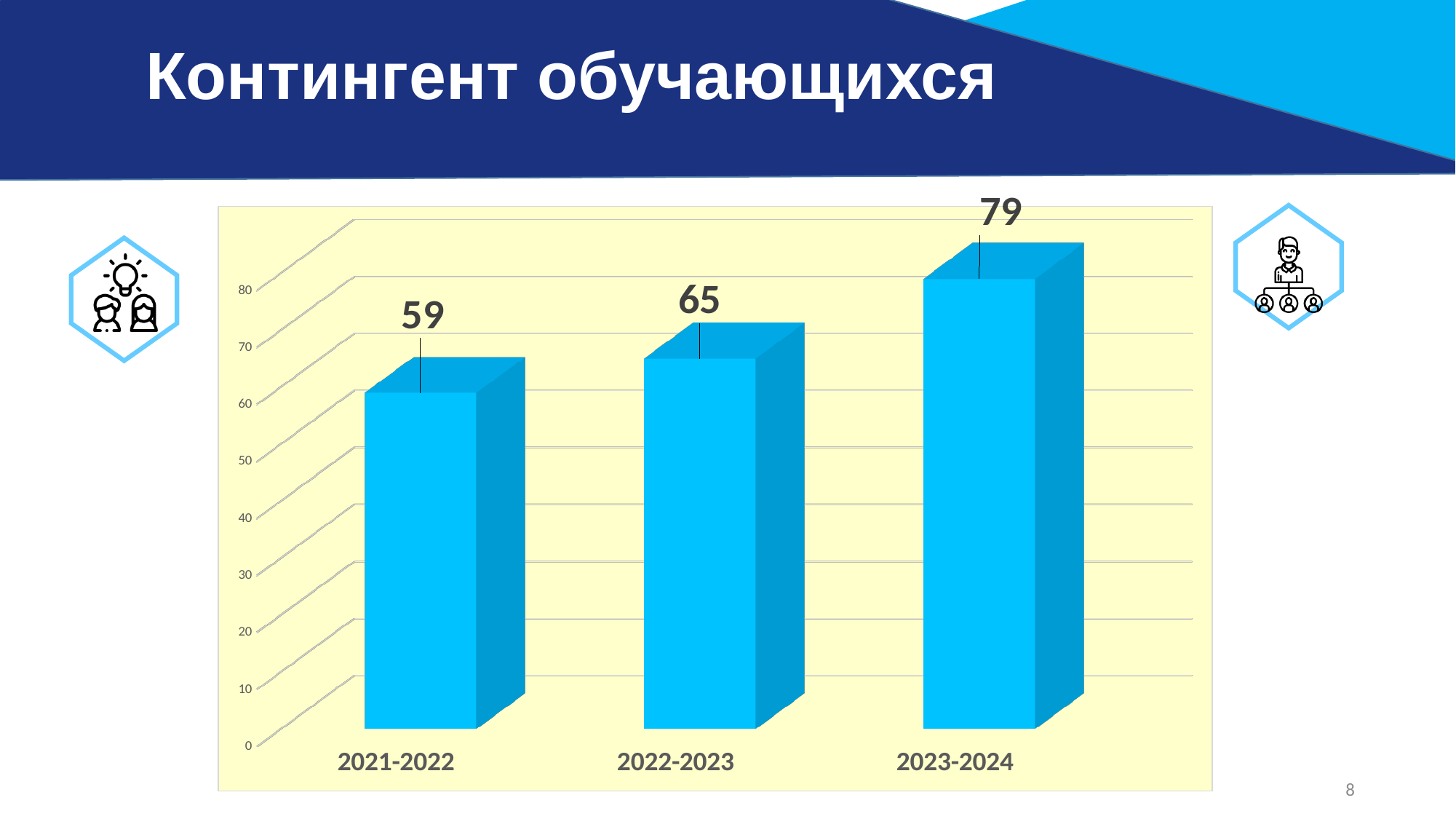
What is the difference between the values for 2023-2024 and 2021-2022? 20 Is the value for 2023-2024 greater or less than 70? greater What is the value for 2021-2022? 59 What kind of chart is shown on the slide? bar chart Which category has the highest value? 2023-2024 What is the value for 2022-2023? 65 How many categories are shown on the x axis? 3 Which is larger, the value for 2022-2023 or the value for 2023-2024? 2023-2024 Which category has the lowest value? 2021-2022 Do the values rise or fall from 2021-2022 to 2023-2024? rise What is the value for 2023-2024? 79 What is the difference between the values for 2022-2023 and 2021-2022? 6